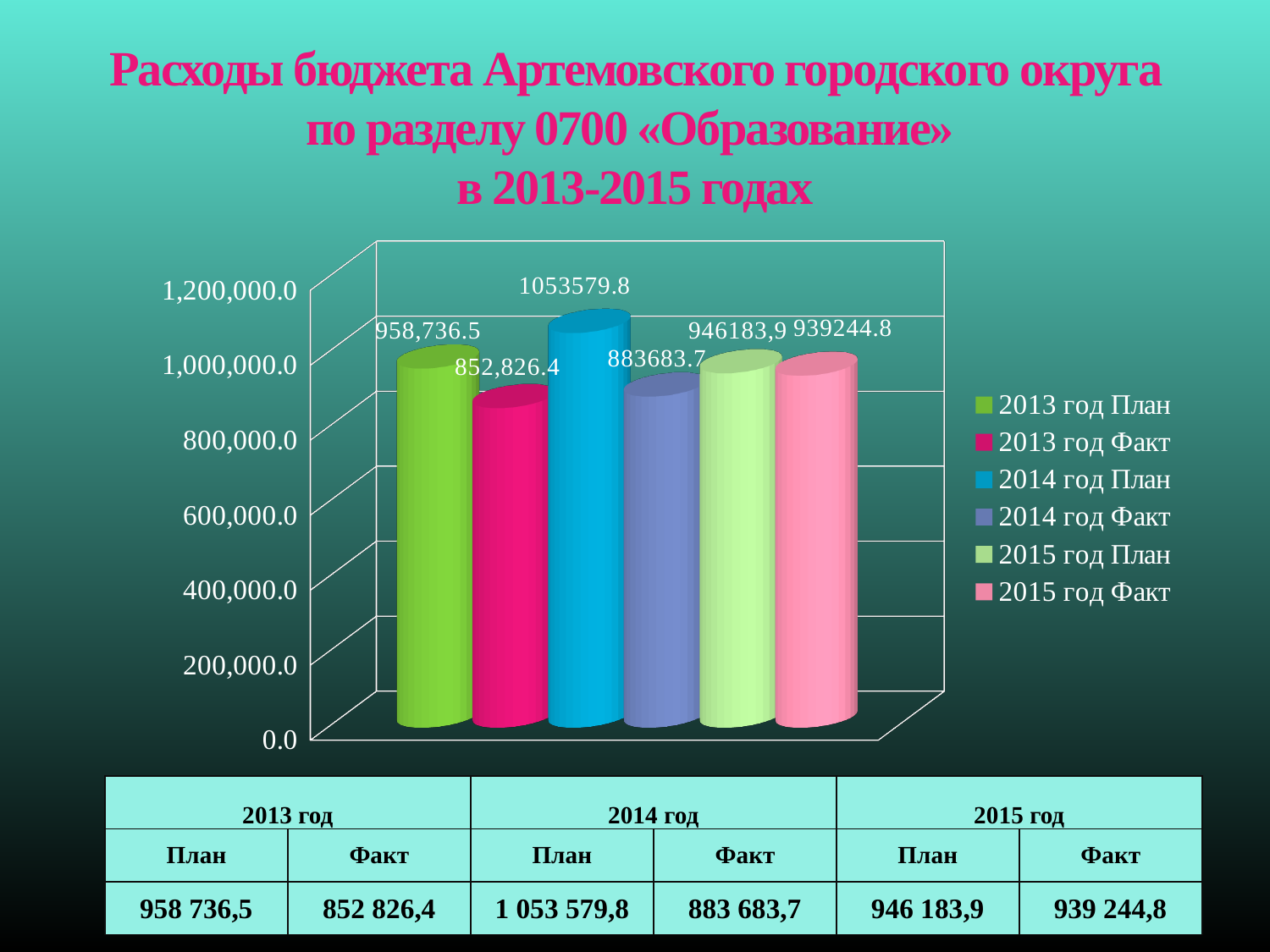
What is the value shown for 2014 год Факт? 883683.7 What colour is the bar for 2014 год План? blue What kind of chart is shown on the slide? bar chart What is the value shown for 2013 год План? 958,736.5 Which series has the lowest value? 2013 год Факт Is the value for 2014 год План greater or less than 1,000,000.0? greater What is the value shown for 2015 год Факт? 939244.8 Which is larger, 2015 год План or 2014 год Факт? 2015 год План Which series has the highest value? 2014 год План What is the difference between 2013 год План and 2013 год Факт? 105,910.1 What is the difference between 2014 год План and 2014 год Факт? 169,896.1 How many series does the legend list? 6